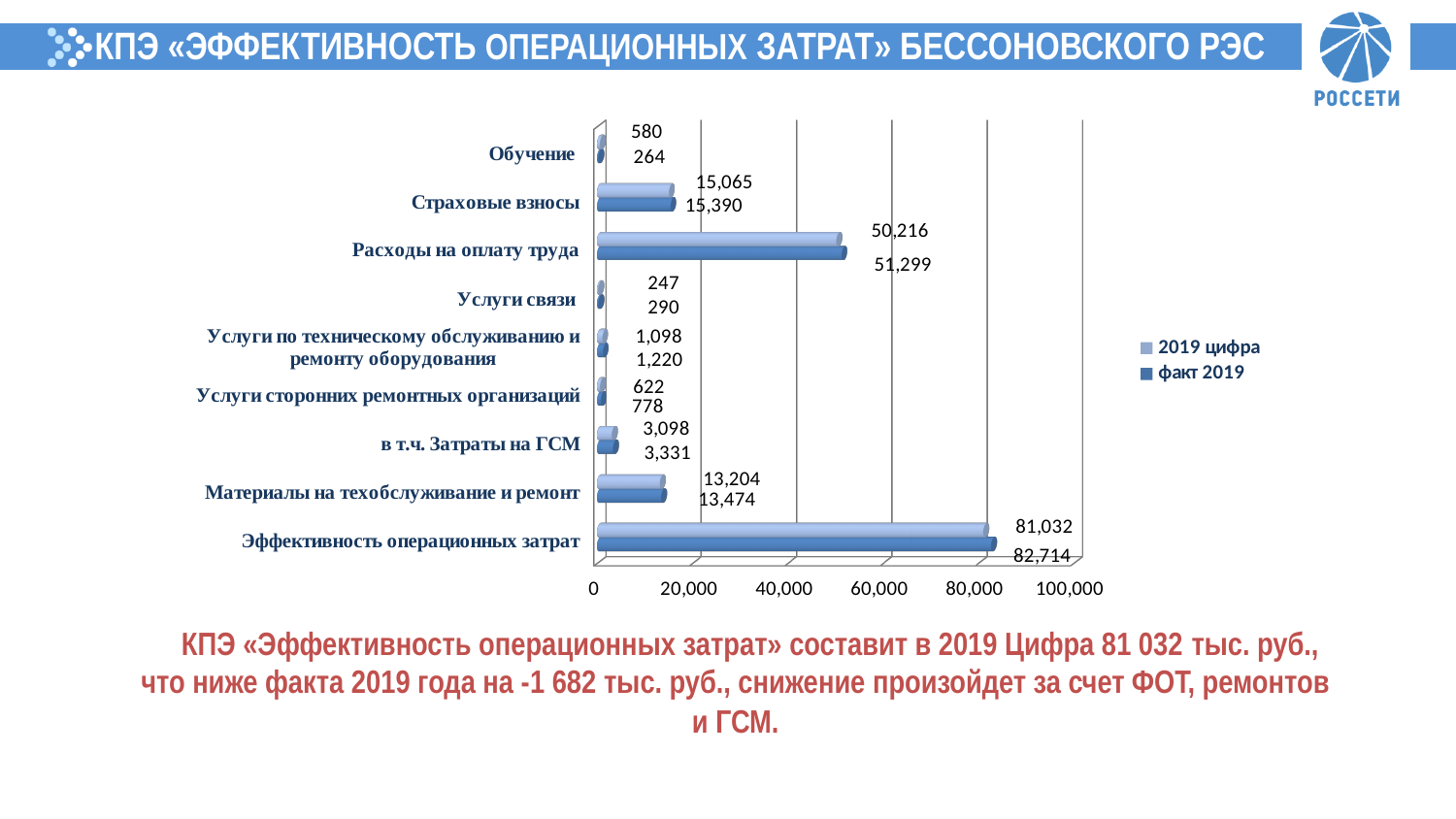
Which series is shown in the darker blue colour in the legend? факт 2019 What is the value of "2019 цифра" for "Расходы на оплату труда"? 50,216 How many categories are shown on the chart? 9 What kind of chart is shown on the slide? bar chart What is the value of "факт 2019" for "Обучение"? 264 For "Страховые взносы", which is larger: "2019 цифра" or "факт 2019"? факт 2019 What is the value of "факт 2019" for "Материалы на техобслуживание и ремонт"? 13,474 Which category has the highest value for "факт 2019"? Эффективность операционных затрат What is the value of "2019 цифра" for "в т.ч. Затраты на ГСМ"? 3,098 What is the difference between "факт 2019" and "2019 цифра" for "Эффективность операционных затрат"? 1,682 Which category has the lowest value for "2019 цифра"? Услуги связи How many series does the chart legend list? 2